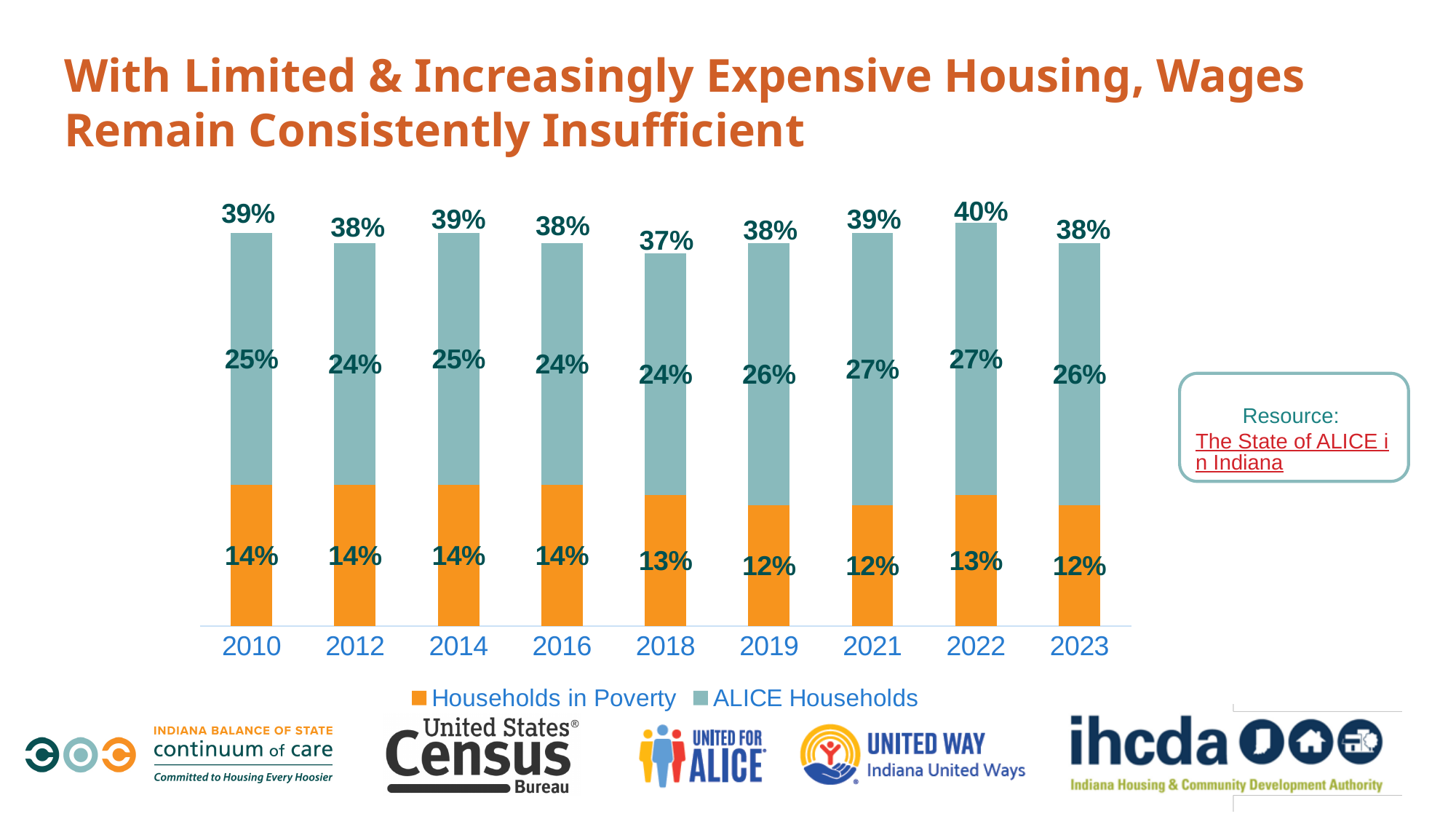
What is the Households in Poverty value for 2023? 12% What is the ALICE Households value for 2021? 27% What kind of chart is shown on the slide? Stacked bar chart What percentage of households were in poverty in 2010? 14% Which year has the highest combined total of Households in Poverty and ALICE Households? 2022 Does the Households in Poverty value rise or fall from 2010 to 2023? Fall Which is larger: the Households in Poverty value in 2014 or in 2019? 2014 How many years are shown on the x axis? 9 How many series does the legend list? 2 Which year has the lowest combined total shown above the bars? 2018 What is the total of the stacked bar for 2018? 37% What is the difference between the ALICE Households value in 2022 and in 2010? 2%